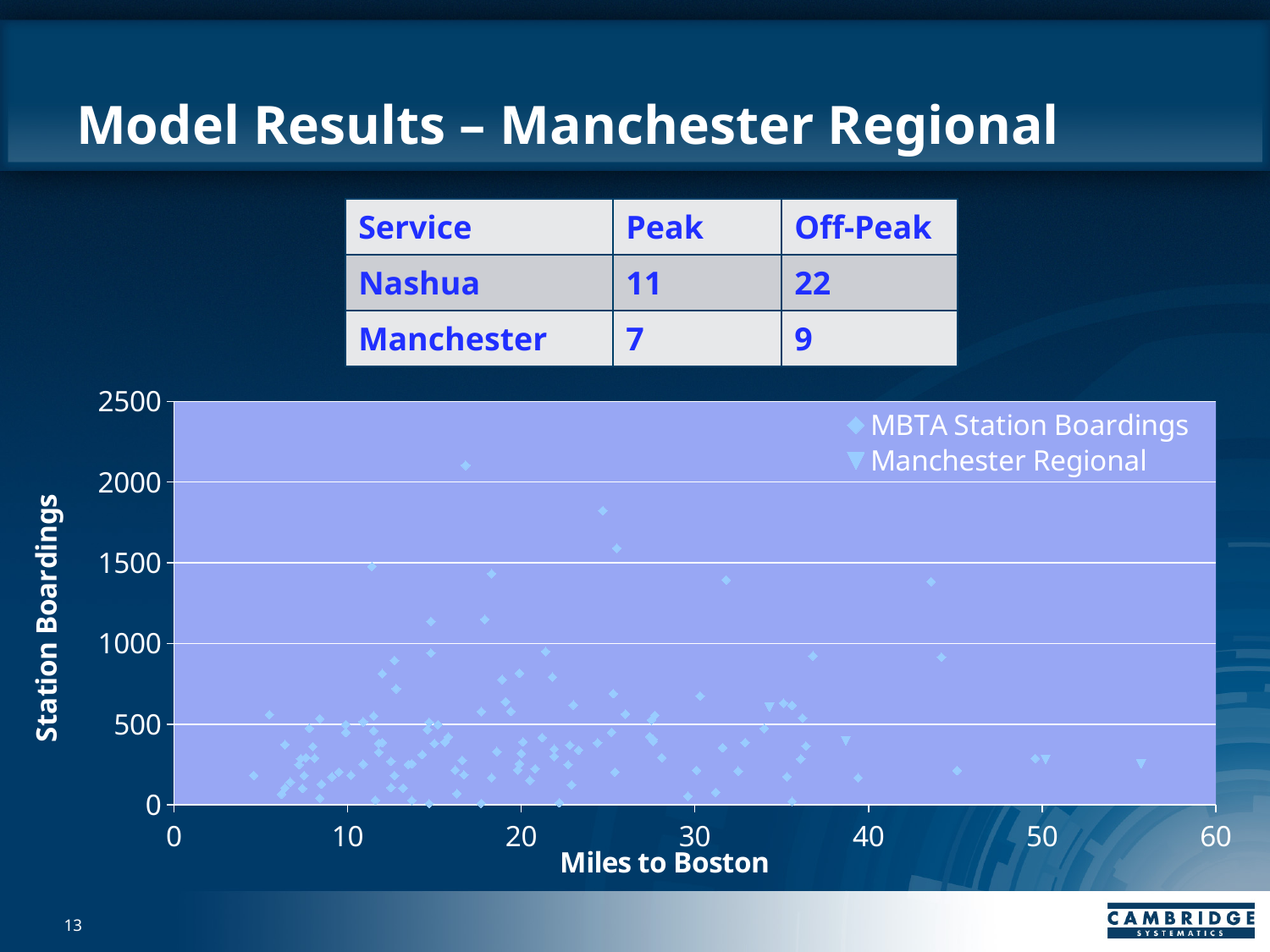
What is the title of the chart's vertical axis? Station Boardings Are all of the Manchester Regional points on the chart greater or less than 1000 boardings? less What is the highest value shown on the Station Boardings axis? 2500 Is the highest MBTA Station Boardings point on the chart greater or less than 2000? greater Is the Manchester Regional point located farthest from Boston (around 55 miles) greater or less than 500 boardings? less What is the title of the chart's horizontal axis? Miles to Boston What kind of chart is shown on the slide? Scatter chart What is the highest value shown on the Miles to Boston axis? 60 What are the two series named in the chart legend? MBTA Station Boardings and Manchester Regional How many series does the chart legend list? 2 Which series contains the point with the highest station boardings on the chart? MBTA Station Boardings